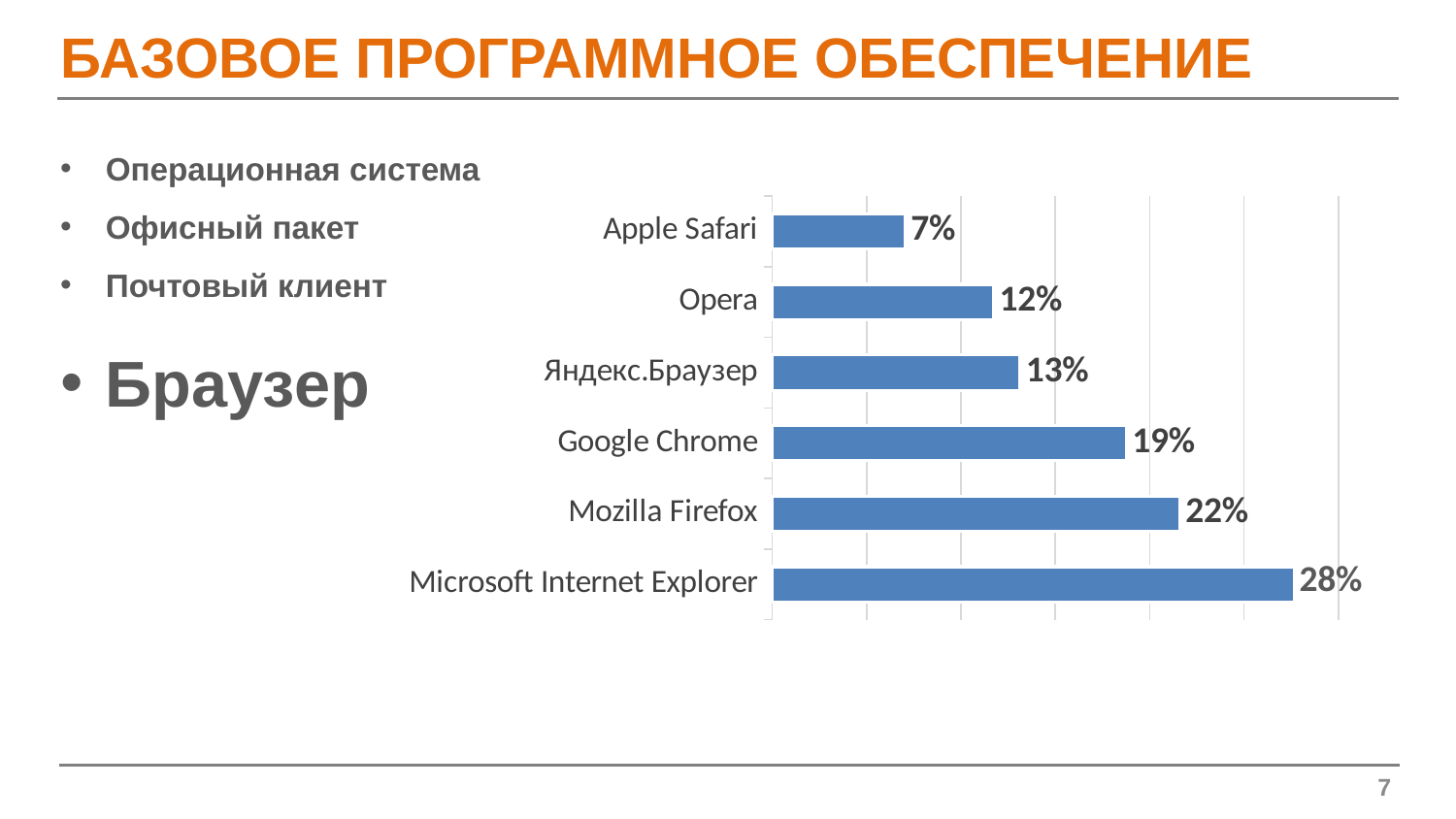
Which is larger, the value for Mozilla Firefox or the value for Google Chrome? Mozilla Firefox What is the difference between the values for Opera and Apple Safari? 5% What is the value for Яндекс.Браузер? 13% How many browsers are shown in the chart? 6 Which browser has the lowest value? Apple Safari What is the value for Apple Safari? 7% What is the value for Google Chrome? 19% What kind of chart is shown on the slide? Bar chart What is the value for Opera? 12% Which browser has the highest value? Microsoft Internet Explorer What is the difference between the values for Microsoft Internet Explorer and Mozilla Firefox? 6% What colour are the bars in the chart? Blue